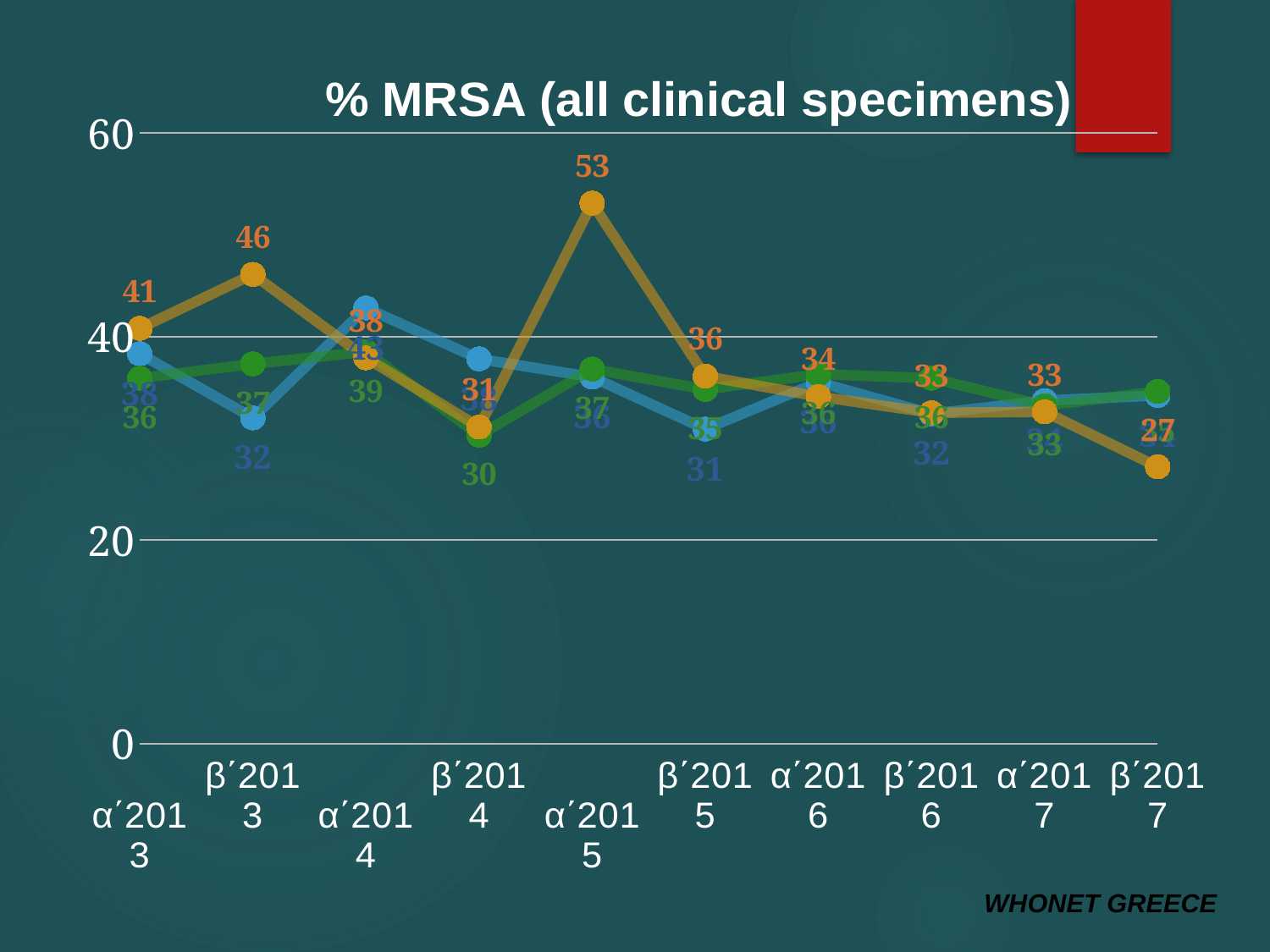
At which period does the orange line reach its lowest value? β΄2017 What is the value of the orange line at β΄2013? 46 What is the value of the orange line at β΄2017? 27 At which period does the orange line reach its highest value? α΄2015 Is the value of the orange line at α΄2015 greater or less than 40? greater What is the difference between the orange line's value at α΄2015 and its value at β΄2017? 26 What kind of chart is shown on the slide? line chart What is the value of the orange line at α΄2015? 53 How many lines are plotted on the chart? 3 What is the title of the chart? % MRSA (all clinical specimens) Which is larger for the orange line: the value at β΄2013 or the value at α΄2013? β΄2013 How many time periods are shown on the x axis? 10